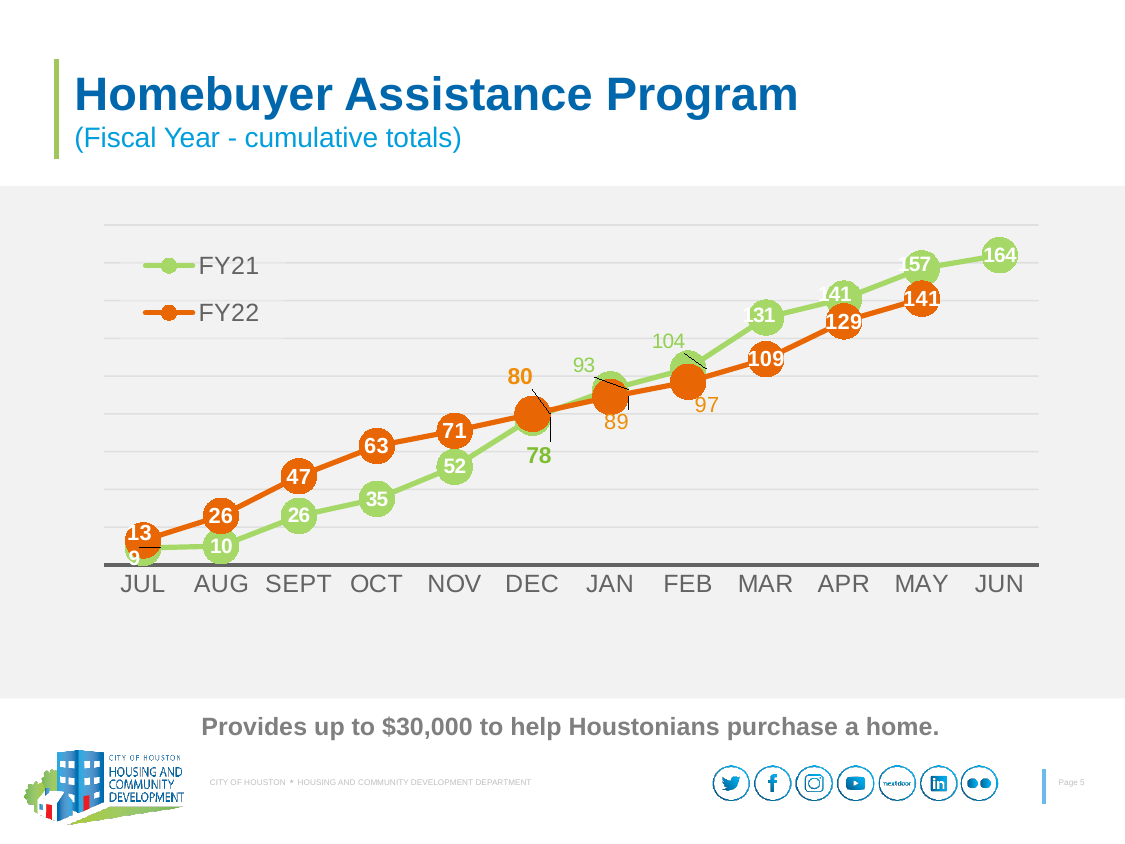
What is the FY21 value for JUN? 164 Which series has the larger value in APR, FY21 or FY22? FY21 How many series does the legend list? 2 Which series has the larger value in NOV, FY21 or FY22? FY22 What kind of chart is shown on the slide? Line chart What is the difference between the FY22 and FY21 values for SEPT? 21 Which month has the highest FY21 value? JUN Which month has the lowest FY22 value? JUL Do the FY22 values rise or fall from JUL to MAY? Rise What is the FY22 value for MAY? 141 What is the FY21 value for DEC? 78 What is the FY22 value for OCT? 63